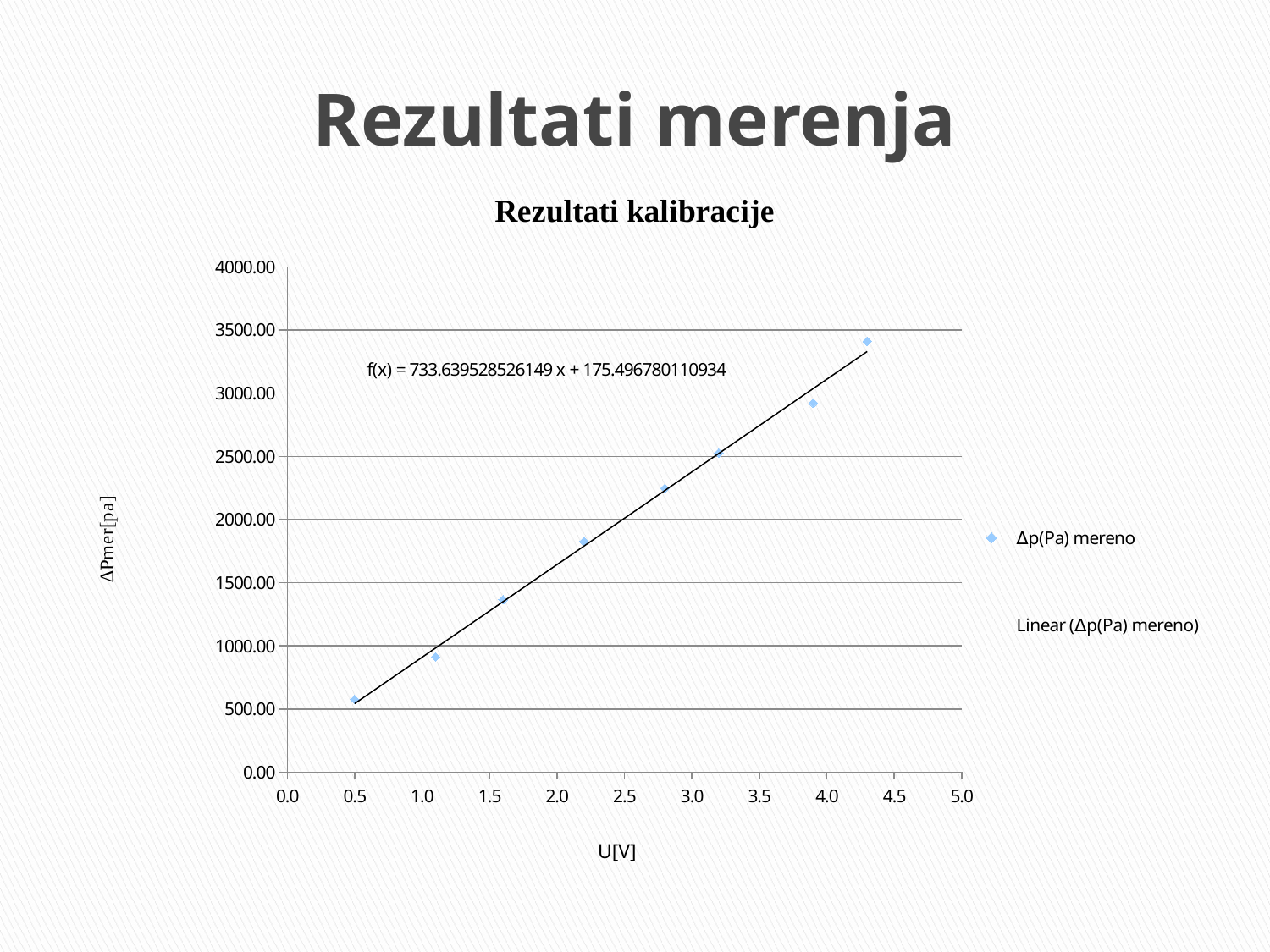
How many data points are plotted for the Δp(Pa) mereno series? 8 Do the Δp(Pa) mereno values rise or fall as U[V] increases? Rise How many entries does the chart legend list? 2 What is the trendline equation printed on the chart? f(x) = 733.639528526149 x + 175.496780110934 Is the Δp(Pa) mereno value at U = 3.9 V greater or less than 3000? less Is the Δp(Pa) mereno value at U = 4.3 V greater or less than 3000? greater What is the title of the chart? Rezultati kalibracije At which U[V] value is the highest Δp(Pa) mereno point plotted? 4.3 Which has the larger Δp(Pa) mereno value, the point at U = 1.6 V or the point at U = 2.8 V? U = 2.8 V Is the Δp(Pa) mereno value at U = 2.2 V greater or less than 1500? greater What kind of chart is shown on the slide? Scatter chart